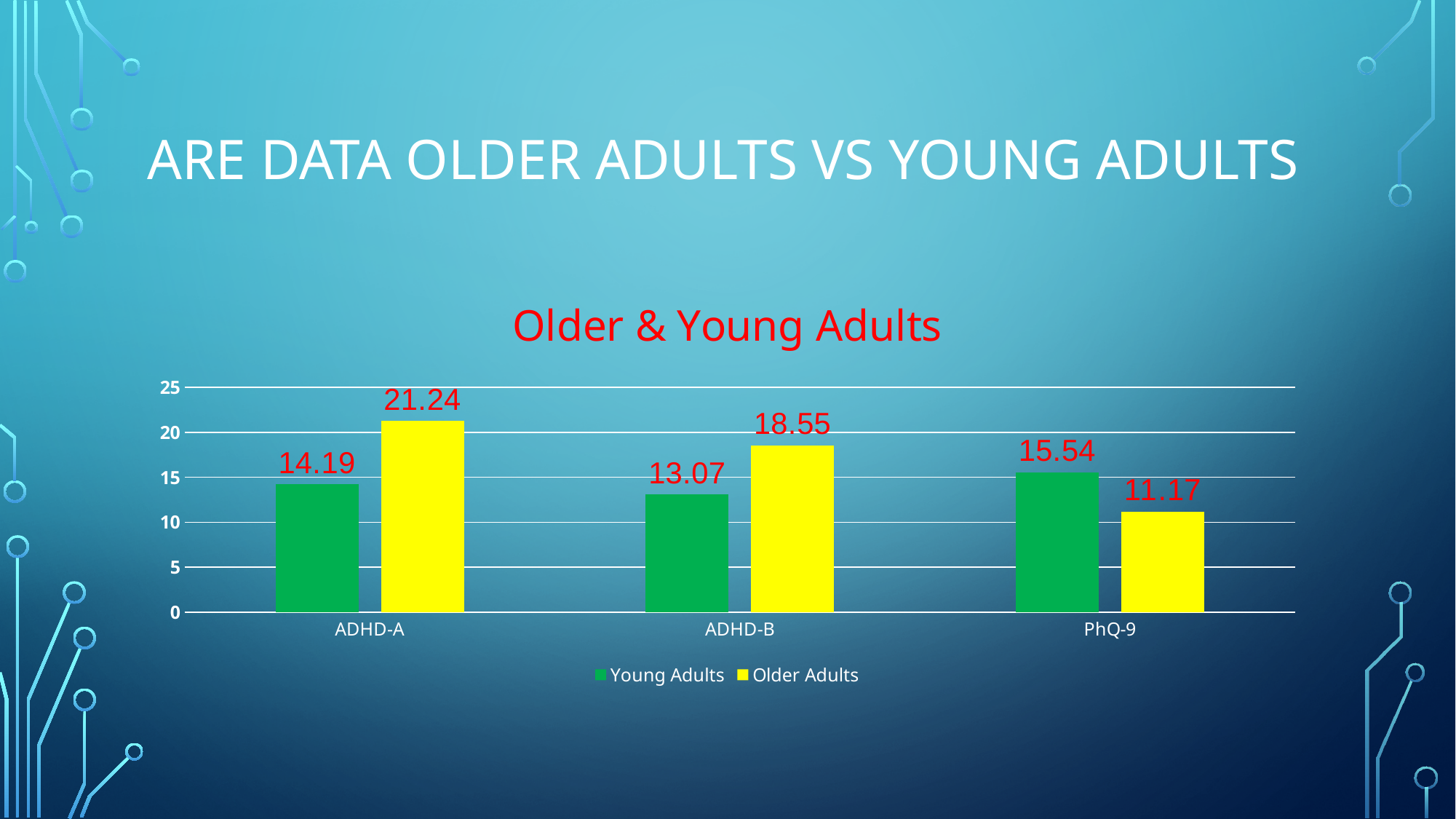
Is the Older Adults value for ADHD-A greater or less than 20? greater Which category has the highest Older Adults value? ADHD-A Which category has the lowest Young Adults value? ADHD-B What is the value for Older Adults in the PhQ-9 category? 11.17 What is the difference between the Older Adults and Young Adults values for ADHD-A? 7.05 How many categories are shown on the x axis? 3 What is the value for Older Adults in the ADHD-B category? 18.55 How many series does the legend list? 2 What kind of chart is shown on the slide? Bar chart What is the title of the chart? Older & Young Adults What is the value for Young Adults in the ADHD-A category? 14.19 In the PhQ-9 category, which series has the larger value, Young Adults or Older Adults? Young Adults